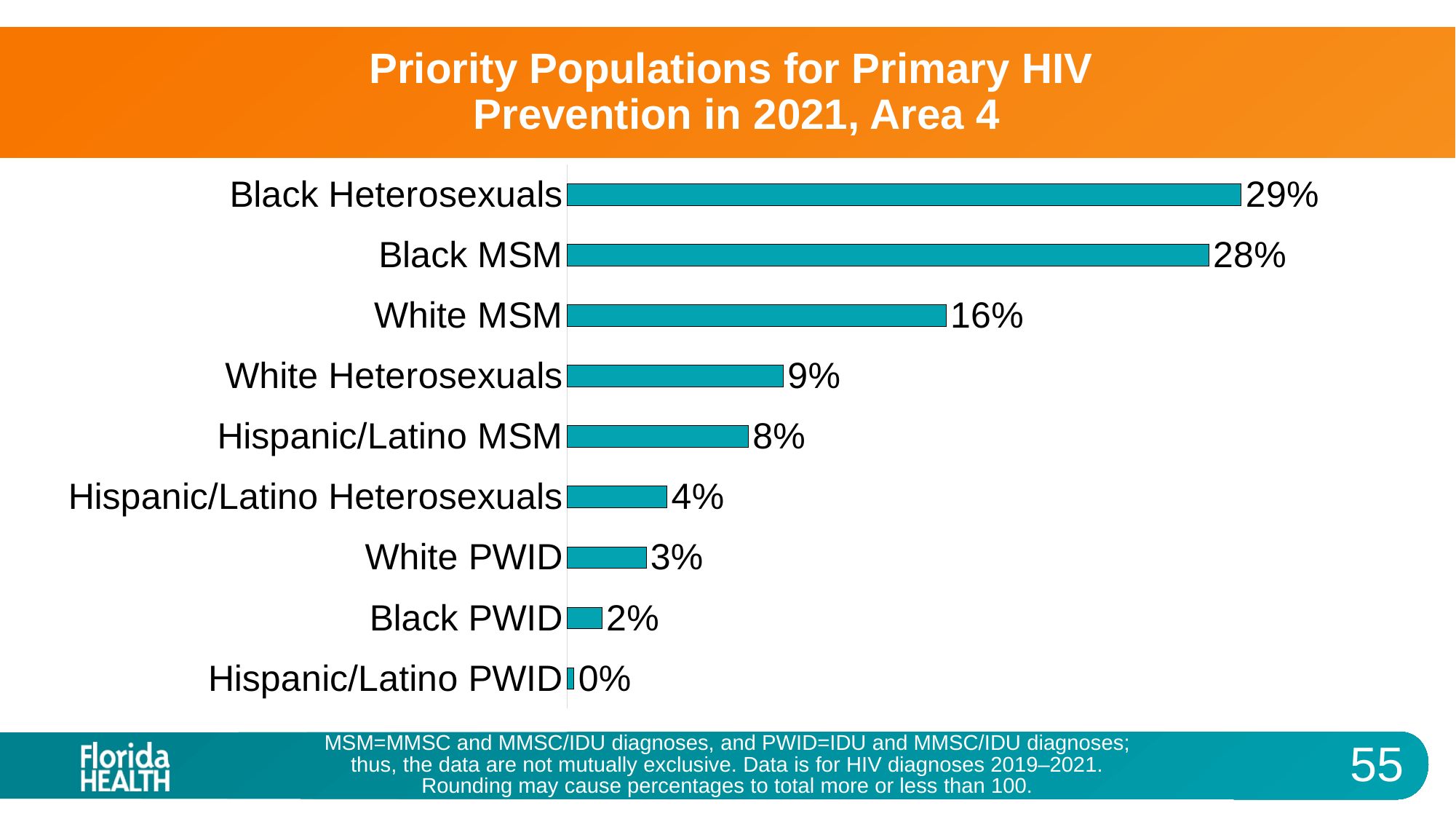
Which category has the lowest value? Hispanic/Latino PWID Which category has the highest value? Black Heterosexuals What is the title of the chart? Priority Populations for Primary HIV Prevention in 2021, Area 4 What is the value for Black PWID? 2% What is the difference between the values for White Heterosexuals and Hispanic/Latino MSM? 1% Which is larger, the value for White PWID or the value for Hispanic/Latino Heterosexuals? Hispanic/Latino Heterosexuals What is the difference between the values for Black MSM and White MSM? 12% What is the value for Hispanic/Latino Heterosexuals? 4% What is the value for Black Heterosexuals? 29% How many categories are shown in the chart? 9 What kind of chart is shown on the slide? Bar chart What is the value for White MSM? 16%